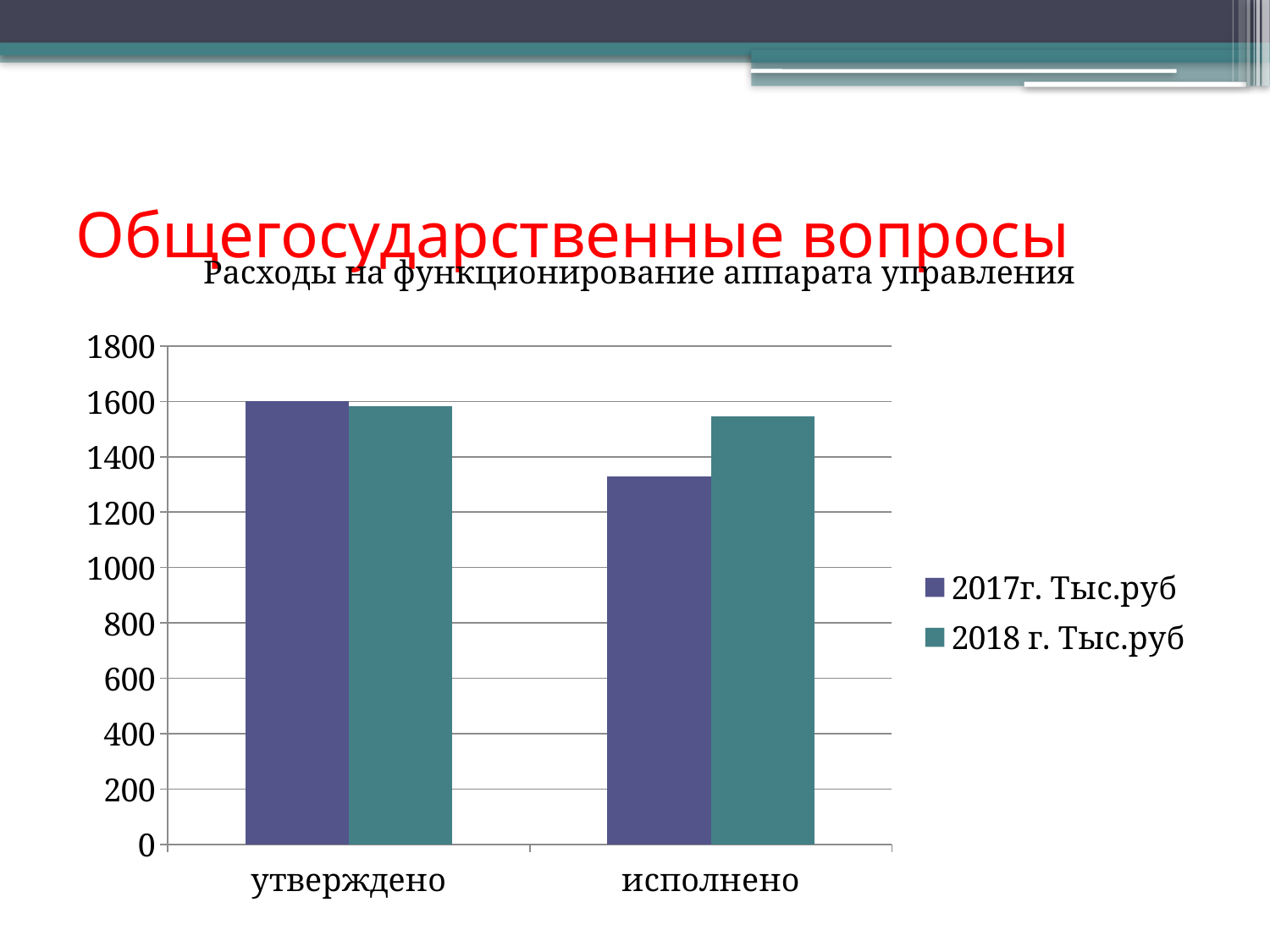
Which series is shown in the teal colour in the legend? 2018 г. Тыс.руб Which bar is the lowest in the whole chart? исполнено, 2017г. Тыс.руб In the 2017г. Тыс.руб series, which category has the lowest value? исполнено How many series does the legend list? 2 Is the value for исполнено in the 2018 г. Тыс.руб series greater or less than 1400? greater Is the value for исполнено in the 2017г. Тыс.руб series greater or less than 1400? less Is the value for утверждено in the 2017г. Тыс.руб series greater or less than 1400? greater What is the title of the chart? Расходы на функционирование аппарата управления What kind of chart is shown on the slide? bar chart How many categories are shown on the x axis? 2 For исполнено, which series has the larger value, 2017г. Тыс.руб or 2018 г. Тыс.руб? 2018 г. Тыс.руб